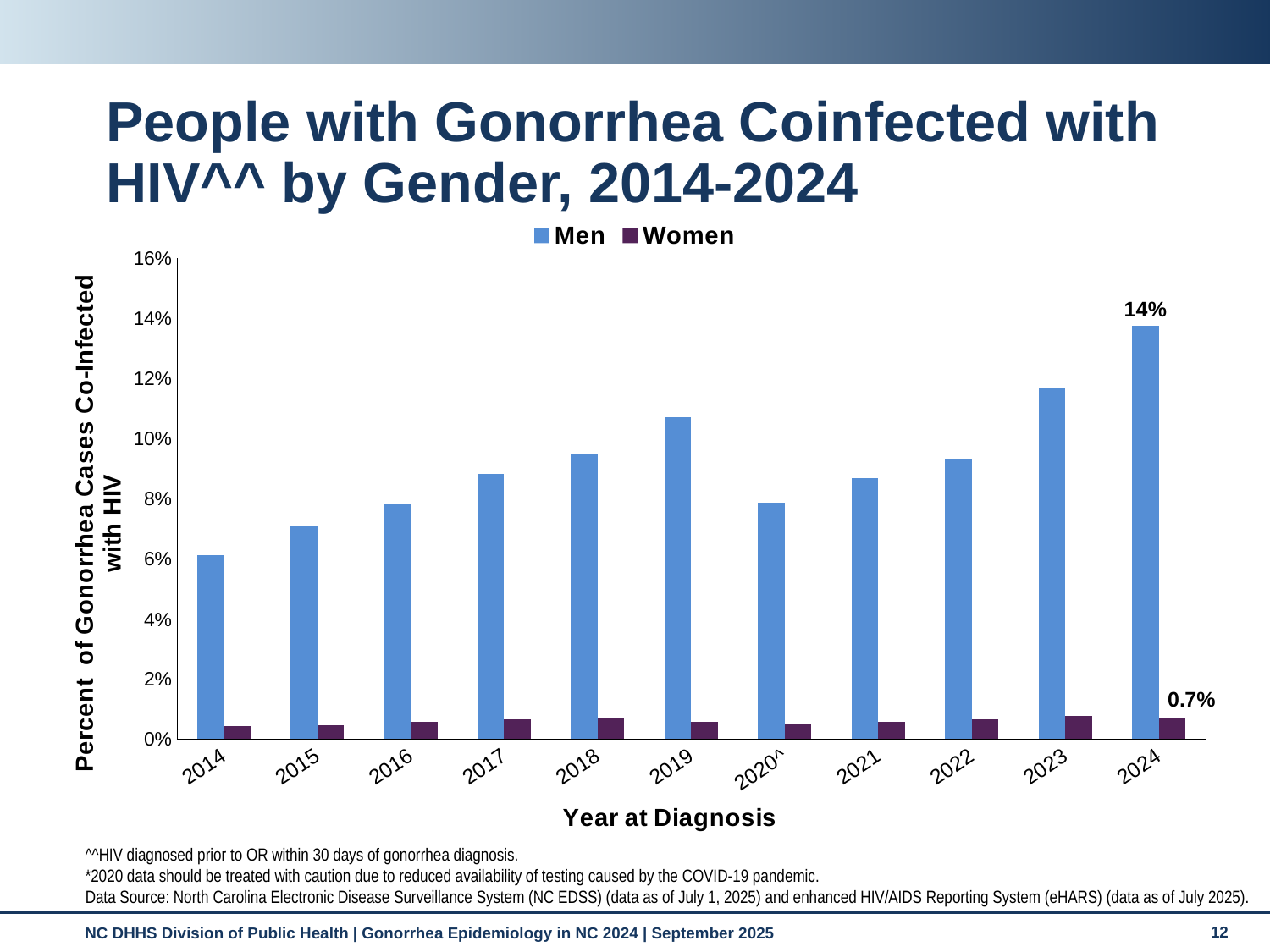
What kind of chart is shown on the slide? Bar chart Is the value for Men in 2014 greater or less than 8%? less How many years are shown on the x axis? 11 What is the value for Women in 2024? 0.7% Which is larger for Men: the value in 2019 or the value in 2020^? 2019 What is the value for Men in 2024? 14% In which year is the value for Men highest? 2024 In which year is the value for Men lowest? 2014 Do the values for Men rise or fall from 2020^ to 2024? Rise What is the difference between the Men and Women values in 2024? 13.3% How many series does the legend list? 2 Is the value for Men in 2019 greater or less than 10%? greater